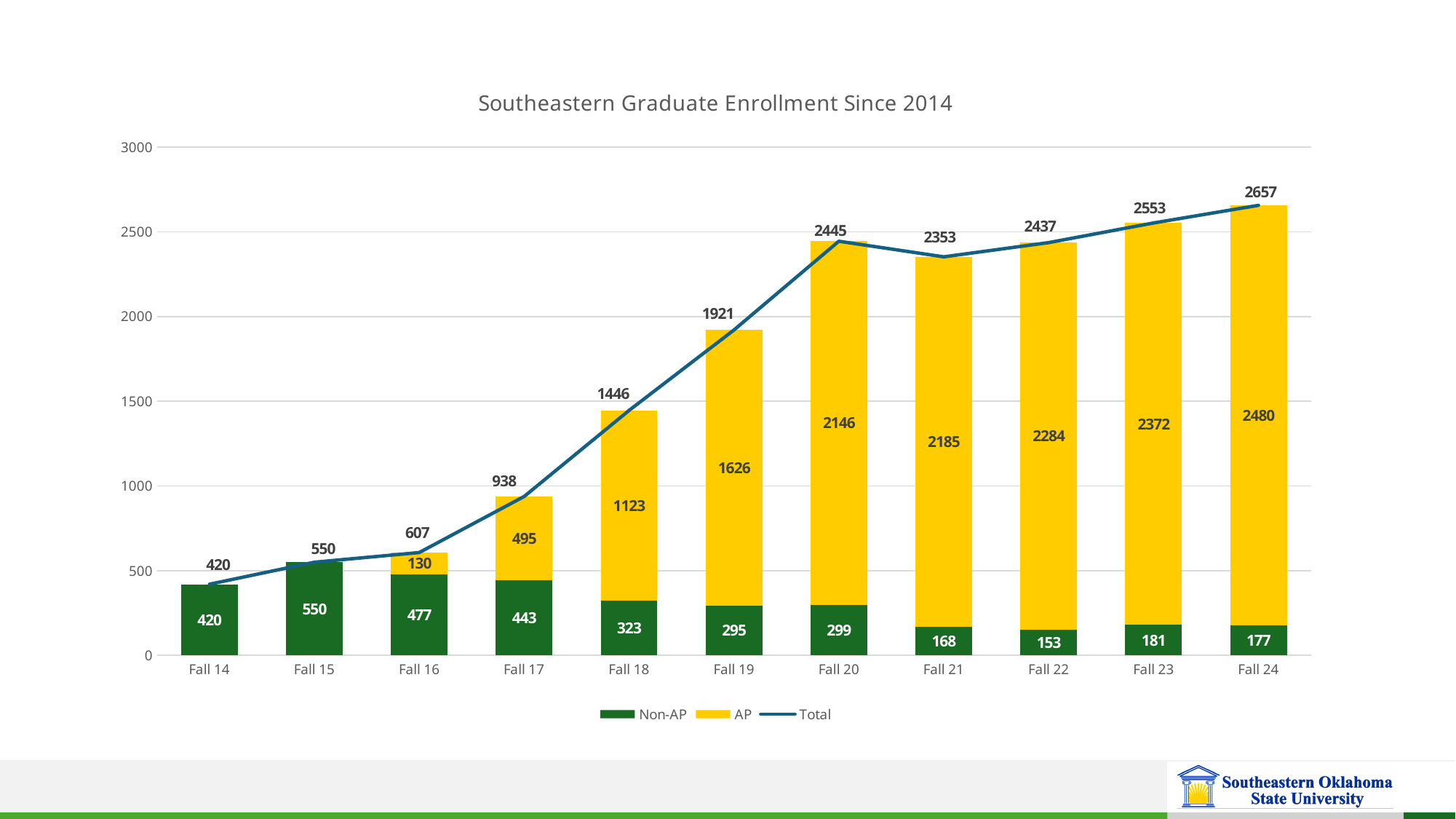
What is the Total value for Fall 20? 2445 Which term has the highest Total value? Fall 24 What is the title of the chart? Southeastern Graduate Enrollment Since 2014 What is the AP value for Fall 22? 2284 Which term has the lowest Non-AP value? Fall 22 What is the Non-AP value for Fall 18? 323 How many series does the legend list? 3 What is the difference between the Total values for Fall 24 and Fall 23? 104 Is the Total value for Fall 17 greater or less than 1000? less Which is larger, the AP value for Fall 19 or the AP value for Fall 18? Fall 19 What kind of chart is this? Stacked bar chart with a line How many terms are shown on the x axis? 11